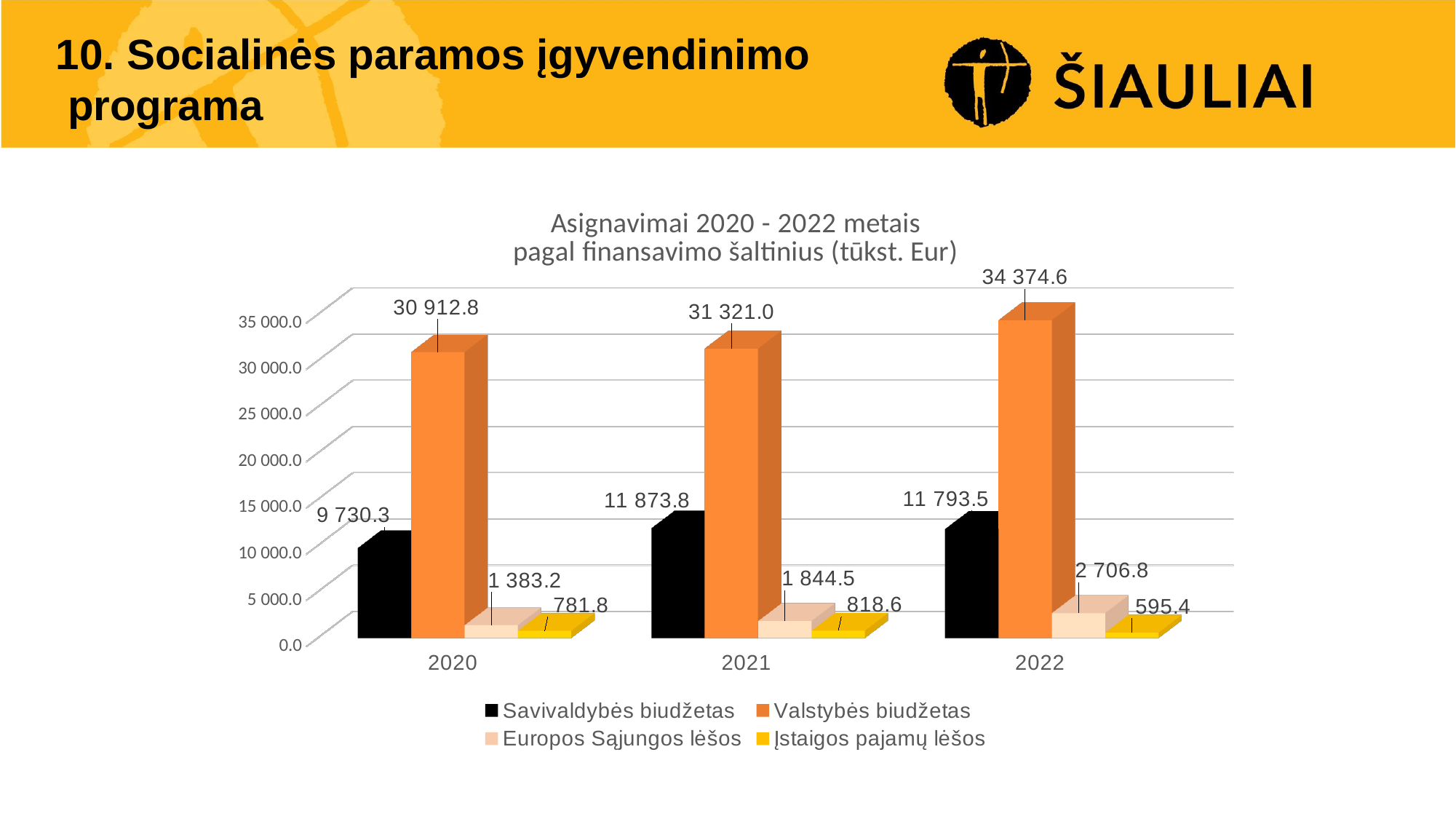
How many years are shown on the x axis? 3 What kind of chart is shown on the slide? bar chart Does the Valstybės biudžetas value rise or fall from 2020 to 2022? rise In which year is the Įstaigos pajamų lėšos value lowest? 2022 What is the value for Savivaldybės biudžetas in 2020? 9 730.3 How many series does the legend list? 4 What is the value for Europos Sąjungos lėšos in 2021? 1 844.5 What is the value for Įstaigos pajamų lėšos in 2022? 595.4 Which is larger: Savivaldybės biudžetas in 2021 or in 2022? 2021 In which year is the Valstybės biudžetas value highest? 2022 What is the value for Valstybės biudžetas in 2022? 34 374.6 What is the difference between the Valstybės biudžetas values for 2022 and 2020? 3 461.8